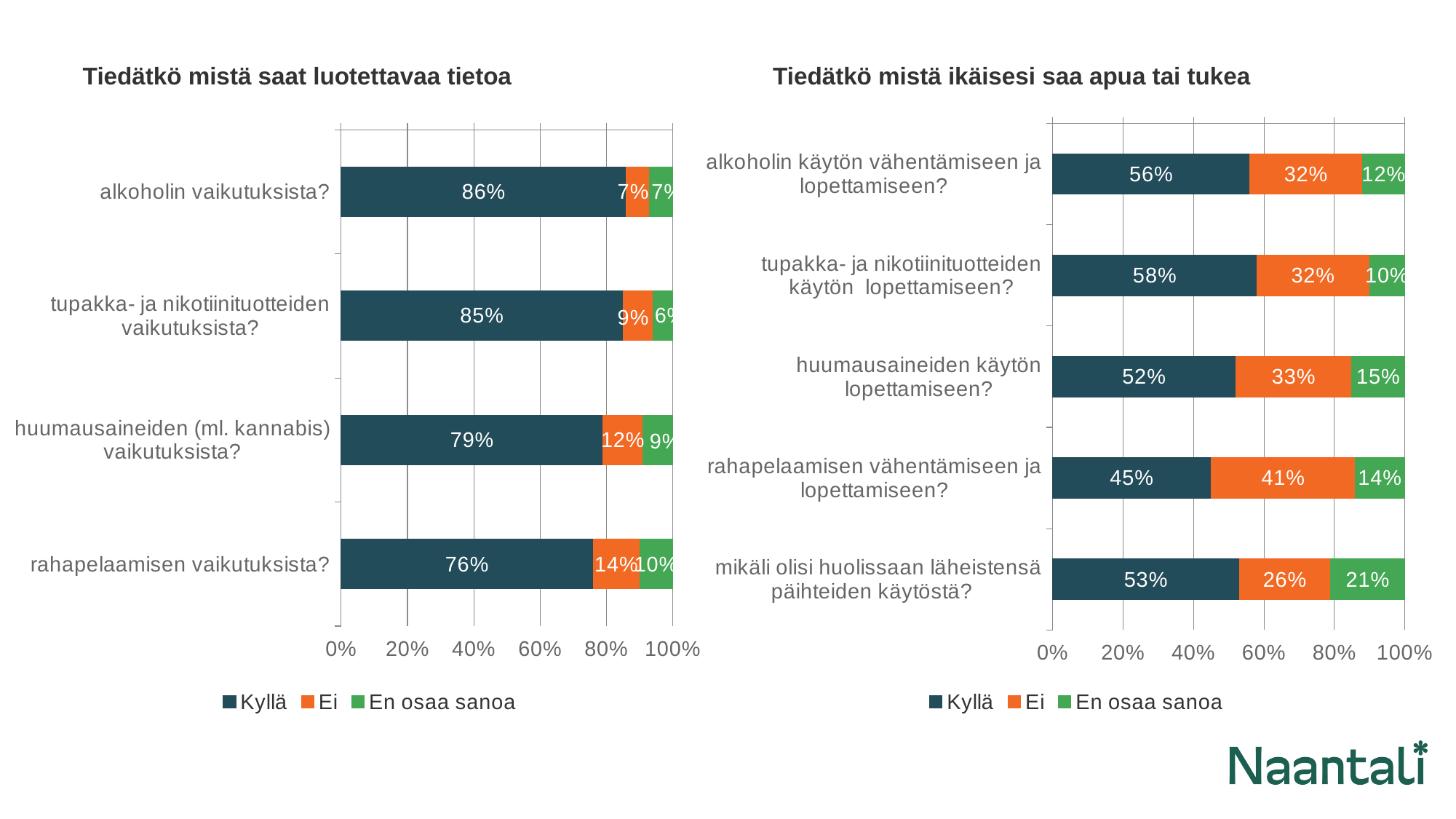
How many series does the legend of the chart titled "Tiedätkö mistä ikäisesi saa apua tai tukea" list? 3 In the chart titled "Tiedätkö mistä saat luotettavaa tietoa", what is the Kyllä value for "alkoholin vaikutuksista?"? 86% In the chart titled "Tiedätkö mistä ikäisesi saa apua tai tukea", what is the En osaa sanoa value for "mikäli olisi huolissaan läheistensä päihteiden käytöstä?"? 21% In the chart titled "Tiedätkö mistä saat luotettavaa tietoa", which category has the lowest Kyllä value? rahapelaamisen vaikutuksista? In the chart titled "Tiedätkö mistä ikäisesi saa apua tai tukea", how many categories are shown? 5 In the chart titled "Tiedätkö mistä ikäisesi saa apua tai tukea", which category has the highest Kyllä value? tupakka- ja nikotiinituotteiden käytön lopettamiseen? In the chart titled "Tiedätkö mistä saat luotettavaa tietoa", what is the Ei value for "rahapelaamisen vaikutuksista?"? 14% In the chart titled "Tiedätkö mistä saat luotettavaa tietoa", how many categories are shown? 4 What type of chart is the chart titled "Tiedätkö mistä saat luotettavaa tietoa"? Stacked bar chart In the chart titled "Tiedätkö mistä ikäisesi saa apua tai tukea", which is larger: the Kyllä value for "huumausaineiden käytön lopettamiseen?" or the Kyllä value for "rahapelaamisen vähentämiseen ja lopettamiseen?"? huumausaineiden käytön lopettamiseen? In the chart titled "Tiedätkö mistä saat luotettavaa tietoa", what is the difference between the Kyllä values for "alkoholin vaikutuksista?" and "huumausaineiden (ml. kannabis) vaikutuksista?"? 7% In the chart titled "Tiedätkö mistä ikäisesi saa apua tai tukea", what is the Ei value for "rahapelaamisen vähentämiseen ja lopettamiseen?"? 41%